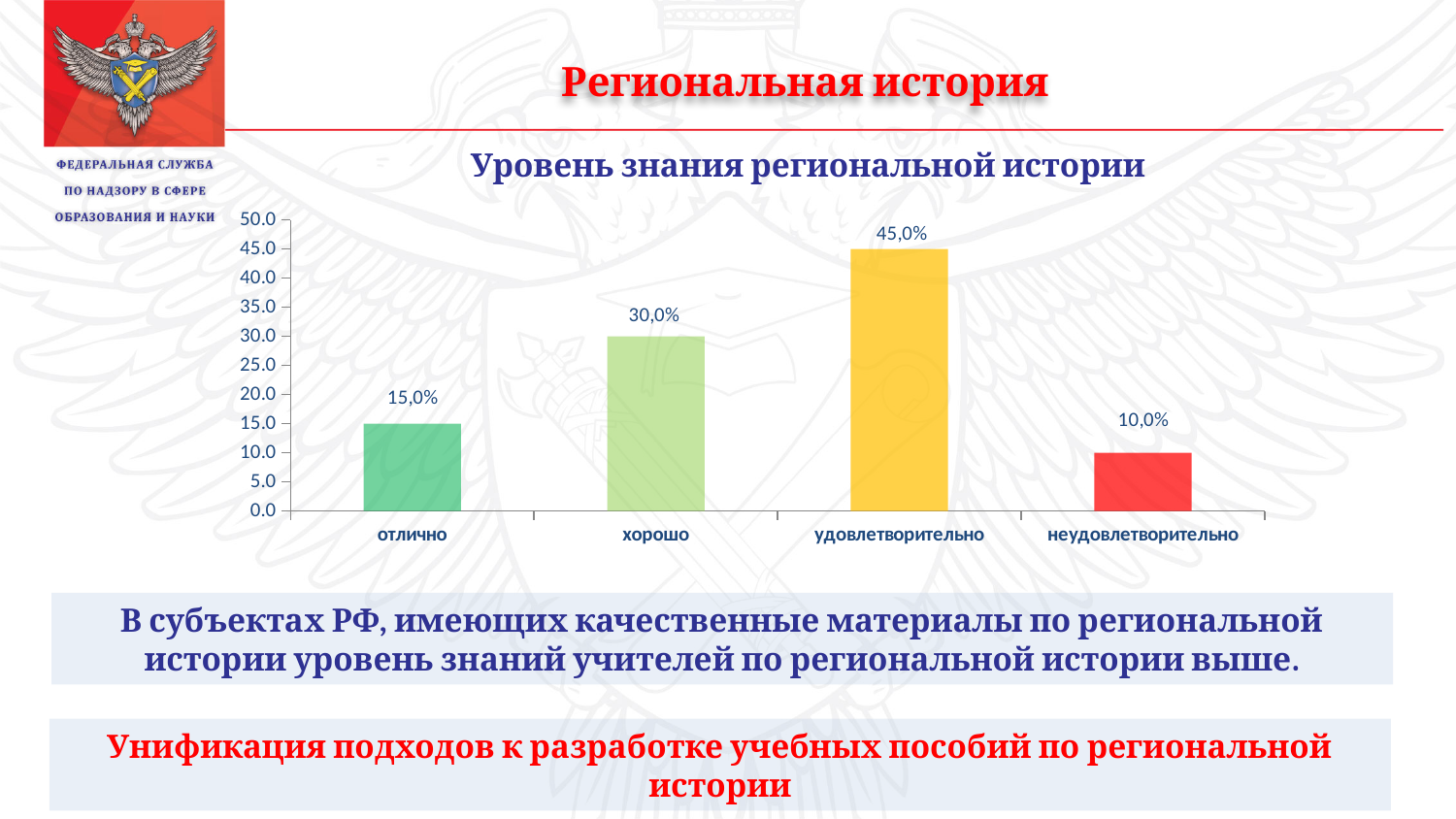
What is the difference between the values for удовлетворительно and хорошо? 15,0% What is the value for хорошо? 30,0% What is the value for отлично? 15,0% Is the value for хорошо greater or less than 25.0? greater Which category has the highest value? удовлетворительно Which category has the lowest value? неудовлетворительно How many categories are shown on the x axis? 4 Which is larger, the value for отлично or the value for неудовлетворительно? отлично What is the value for удовлетворительно? 45,0% What is the title of the chart? Уровень знания региональной истории What is the value for неудовлетворительно? 10,0% What kind of chart is shown on the slide? bar chart